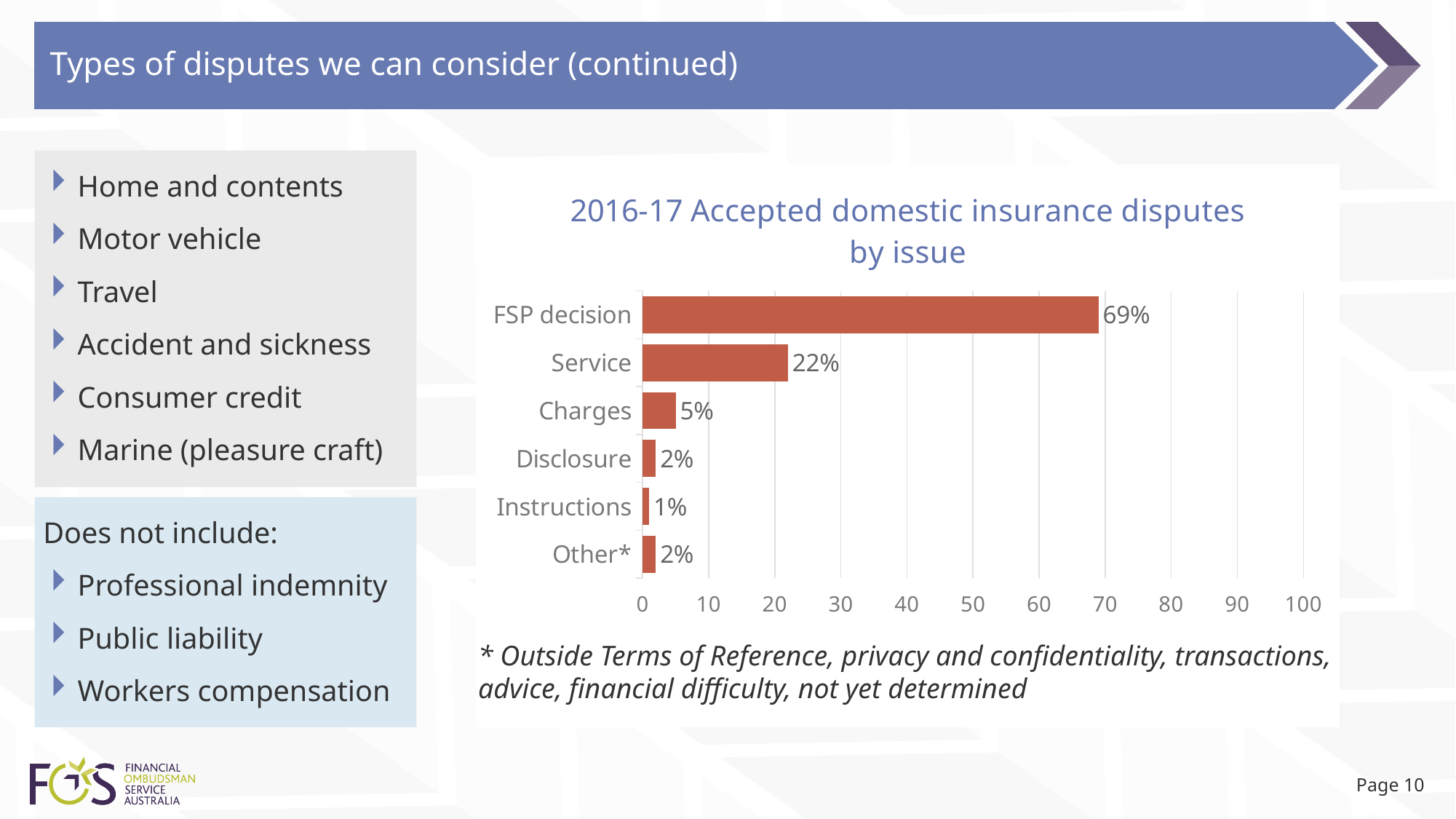
Which issue has the highest share of accepted domestic insurance disputes? FSP decision Which issue has the lowest share of accepted domestic insurance disputes? Instructions What is the value for FSP decision? 69% What is the value for Instructions? 1% How many issue categories are shown in the chart? 6 Is the value for Service greater or less than 30? less What is the title of the chart? 2016-17 Accepted domestic insurance disputes by issue What is the value for Service? 22% What kind of chart is shown on the slide? Bar chart What is the difference between the values for FSP decision and Service? 47% Which is larger, the value for Charges or the value for Disclosure? Charges What is the value for Charges? 5%